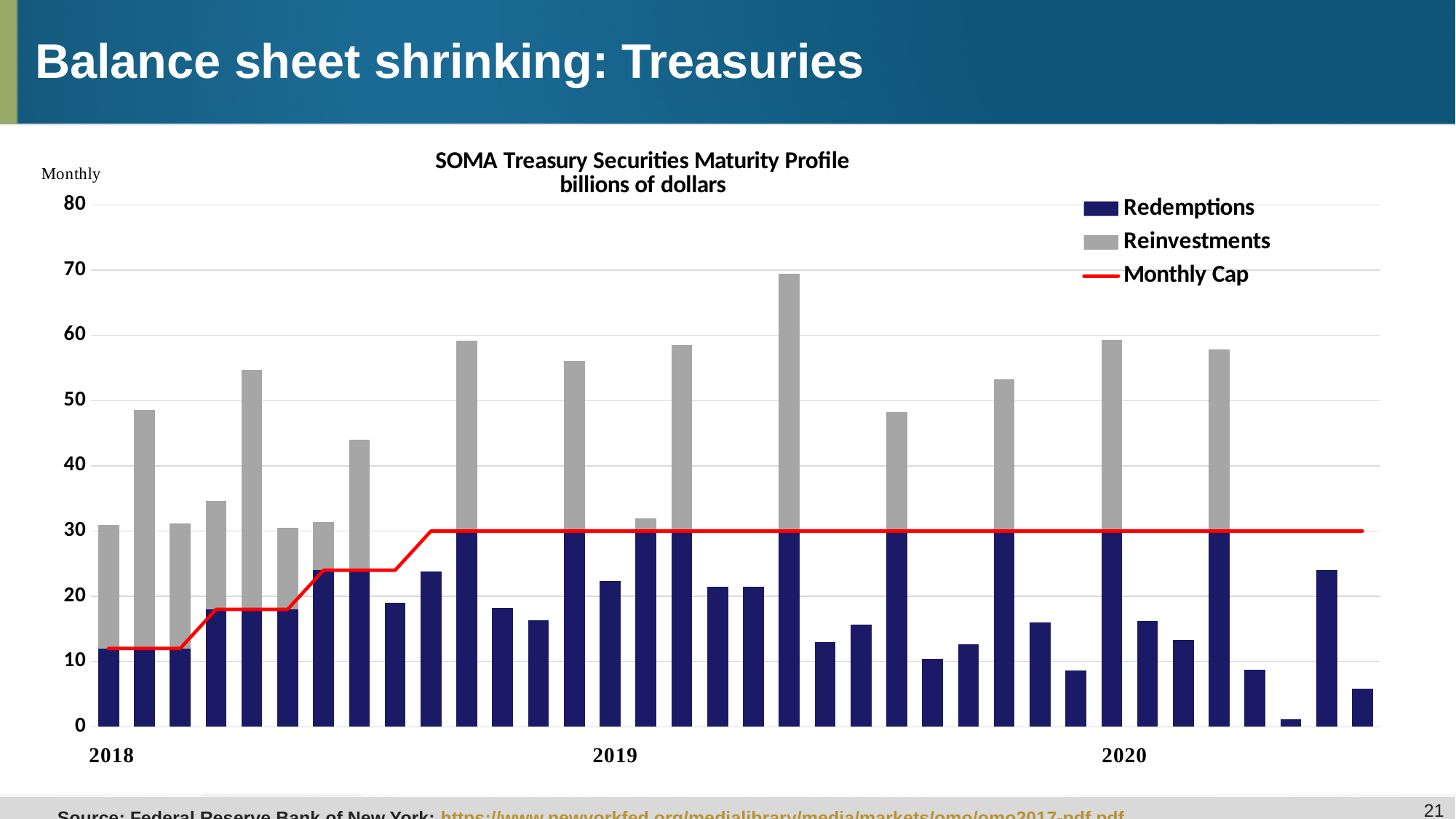
Does the Monthly Cap line rise or fall over the course of 2018? Rise In which year does the tallest Reinvestments bar appear? 2019 What unit is the chart measured in, according to the subtitle? billions of dollars Which series is shown in gray? Reinvestments Is the first Redemptions bar in 2018 greater or less than 20? less How many series does the chart legend list? 3 Is the tallest Reinvestments bar greater or less than 60? greater Which is larger, the first Reinvestments bar in 2018 or the first Redemptions bar in 2018? Reinvestments What is the title of the chart? SOMA Treasury Securities Maturity Profile What kind of chart is used to show Redemptions and Reinvestments? Bar chart What value does the Monthly Cap line reach and hold from late 2018 onward? 30 Is the last Redemptions bar on the right of the chart greater or less than 10? less